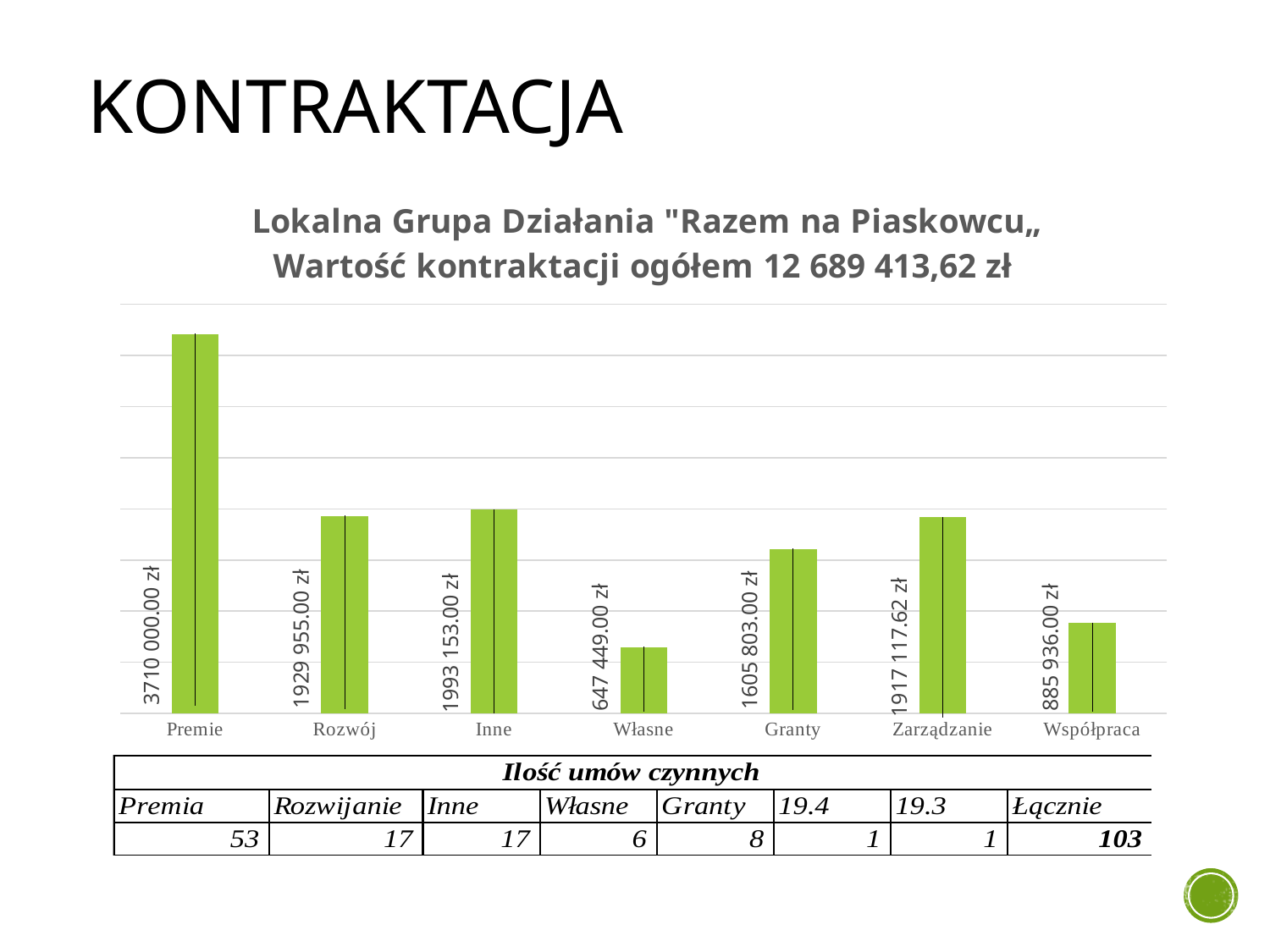
What total contract value (Wartość kontraktacji ogółem) is stated in the chart title? 12 689 413,62 zł What is the value for Współpraca? 885 936.00 zł What is the value for Granty? 1605 803.00 zł How many categories are shown on the x axis? 7 What is the value for Premie? 3710 000.00 zł Which category has the highest value? Premie What kind of chart is shown? Bar chart Which is larger, the value for Inne or the value for Rozwój? Inne What is the difference between the values for Premie and Własne? 3 062 551.00 zł Which category has the lowest value? Własne What is the difference between the values for Granty and Współpraca? 719 867.00 zł What is the value for Zarządzanie? 1917 117.62 zł